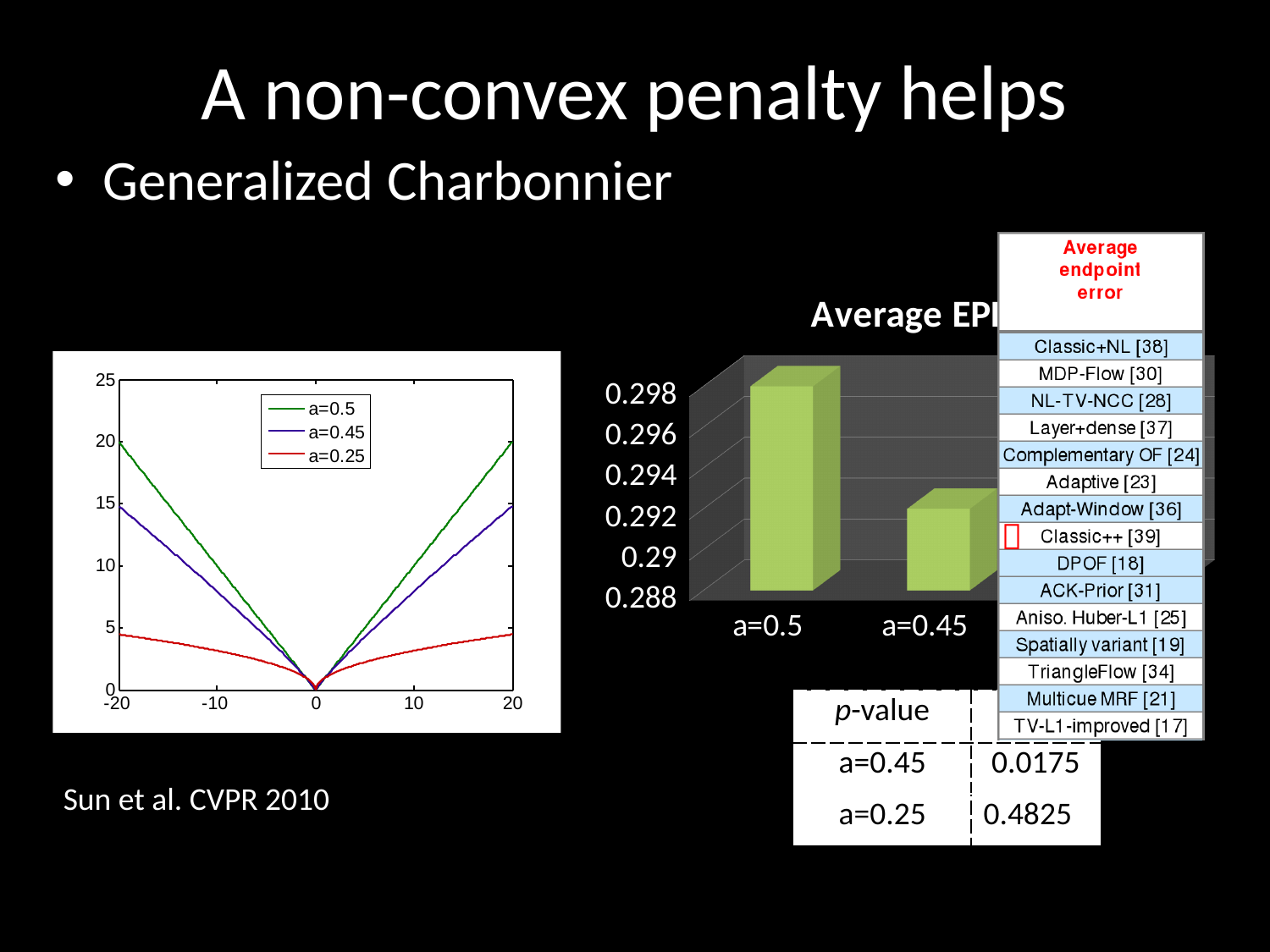
In the left line chart, is the value of the a=0.5 series at x = -20 greater or less than 15? greater In the Average EPE bar chart, is the value for a=0.5 greater or less than 0.296? greater In the left line chart, which series has the highest value at x = 20? a=0.5 In the left line chart, which series has the lowest value at x = 20? a=0.25 In the left line chart, is the value of the a=0.25 series at x = 20 greater or less than 5? less How many series does the legend of the left line chart list? 3 In the Average EPE bar chart, which is larger, the value for a=0.5 or the value for a=0.45? a=0.5 What kind of chart is the chart on the left of the slide? line chart In the left line chart, what is the value of the a=0.5 series at x = 20? 20 What kind of chart is the Average EPE chart on the right of the slide? bar chart In the left line chart, what is the value of all three series at x = 0? 0